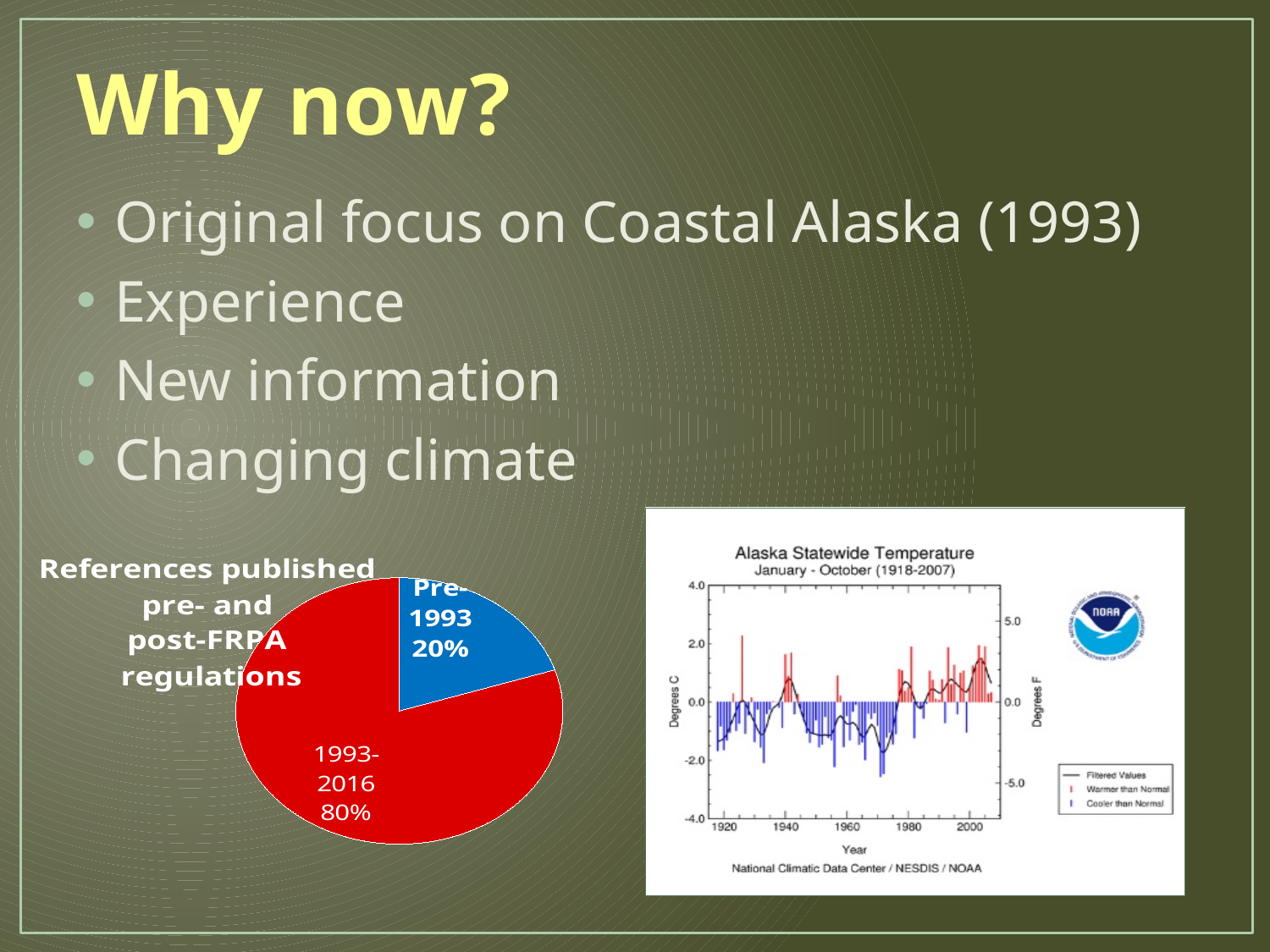
On the "Alaska Statewide Temperature" chart, how many entries does the legend list? 3 On the pie chart titled "References published pre- and post-FRPA regulations", what is the difference in percentage points between the 1993-2016 slice and the Pre-1993 slice? 60 percentage points On the pie chart titled "References published pre- and post-FRPA regulations", what colour is the 1993-2016 slice? Red On the pie chart titled "References published pre- and post-FRPA regulations", what share of references were published pre-1993? 20% On the pie chart titled "References published pre- and post-FRPA regulations", what share of references were published in 1993-2016? 80% What kind of chart is the one on the lower left of the slide, titled "References published pre- and post-FRPA regulations"? Pie chart On the "Alaska Statewide Temperature" chart, is the value for 1970 greater or less than 0.0 degrees C? less On the pie chart titled "References published pre- and post-FRPA regulations", how many slices are there? 2 What is the title of the chart on the lower right of the slide? Alaska Statewide Temperature On the "Alaska Statewide Temperature" chart, what is the label of the x axis? Year On the pie chart titled "References published pre- and post-FRPA regulations", which slice is the largest? 1993-2016 On the pie chart titled "References published pre- and post-FRPA regulations", which slice is the smallest? Pre-1993